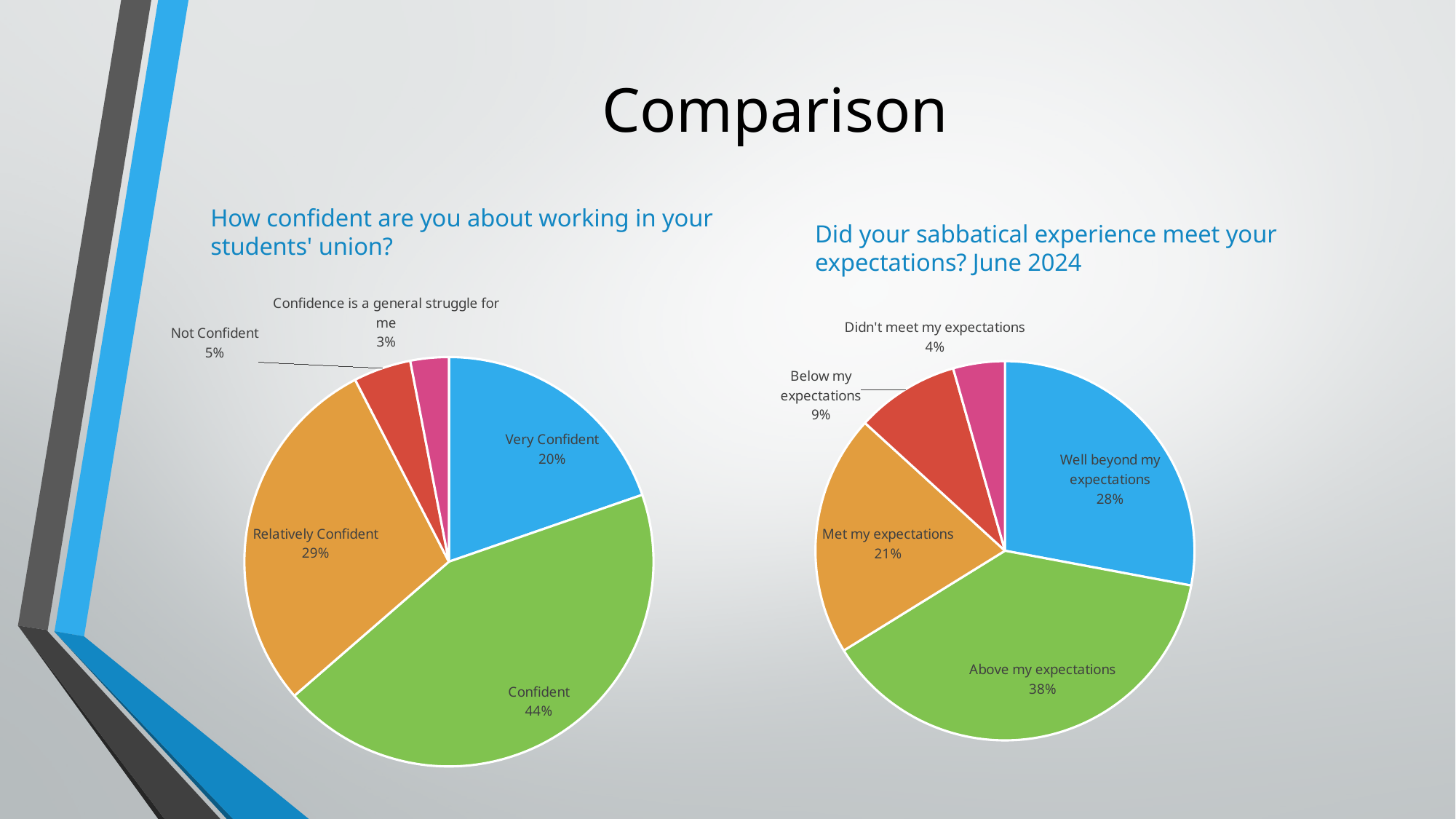
In the right pie chart (Did your sabbatical experience meet your expectations? June 2024), what is the difference between Above my expectations and Well beyond my expectations? 10% In the left pie chart (How confident are you about working in your students' union?), how many slices are there? 5 In the right pie chart (Did your sabbatical experience meet your expectations? June 2024), what share is labelled for Above my expectations? 38% In the left pie chart (How confident are you about working in your students' union?), which category has the largest slice? Confident What type of chart is used for both charts on the slide? Pie chart In the right pie chart (Did your sabbatical experience meet your expectations? June 2024), which category has the smallest slice? Didn't meet my expectations In the right pie chart (Did your sabbatical experience meet your expectations? June 2024), what share is labelled for Below my expectations? 9% In the left pie chart (How confident are you about working in your students' union?), which category has the smallest slice? Confidence is a general struggle for me In the right pie chart (Did your sabbatical experience meet your expectations? June 2024), which is larger, Well beyond my expectations or Met my expectations? Well beyond my expectations In the left pie chart (How confident are you about working in your students' union?), what share is labelled for Confident? 44% In the left pie chart (How confident are you about working in your students' union?), what share is labelled for Relatively Confident? 29% In the left pie chart (How confident are you about working in your students' union?), what is the difference between Very Confident and Not Confident? 15%